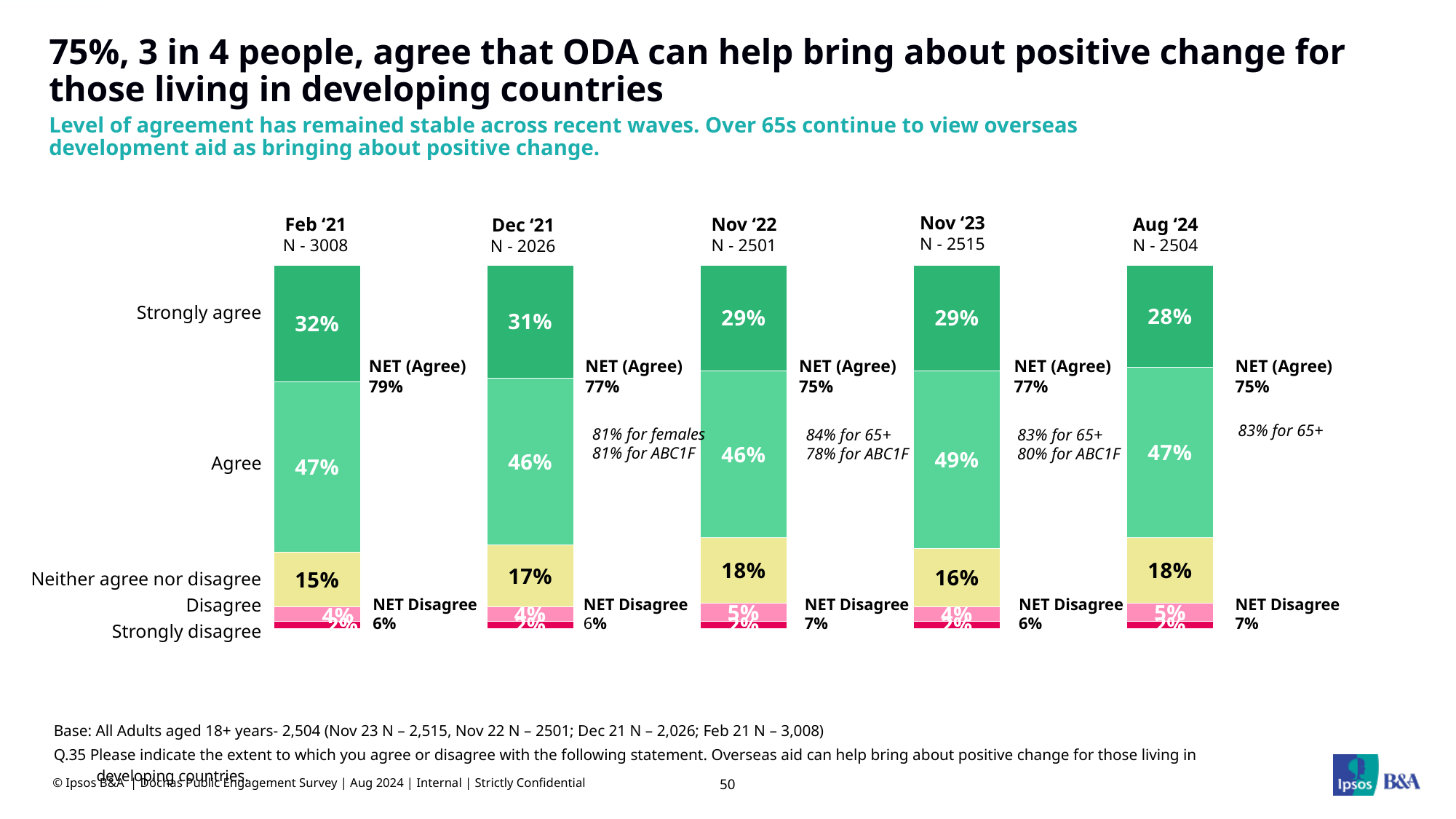
What type of chart is shown on the slide? Stacked bar chart What percentage of respondents chose 'Neither agree nor disagree' in Aug '24? 18% What percentage of respondents chose 'Agree' in Nov '23? 49% What percentage of respondents strongly agreed in Feb '21? 32% What is the NET (Agree) figure for Dec '21? 77% Is the 'Strongly agree' percentage higher in Dec '21 or in Aug '24? Dec '21 How many survey waves are shown in the chart? 5 Does the 'Strongly agree' percentage rise or fall from Feb '21 to Aug '24? Fall What is the sample size (N) for the Nov '22 wave? 2501 What is the difference between the 'Agree' percentage in Nov '23 and in Dec '21? 3 percentage points Which wave has the lowest 'Neither agree nor disagree' percentage? Feb '21 Which wave has the highest 'Strongly agree' percentage? Feb '21